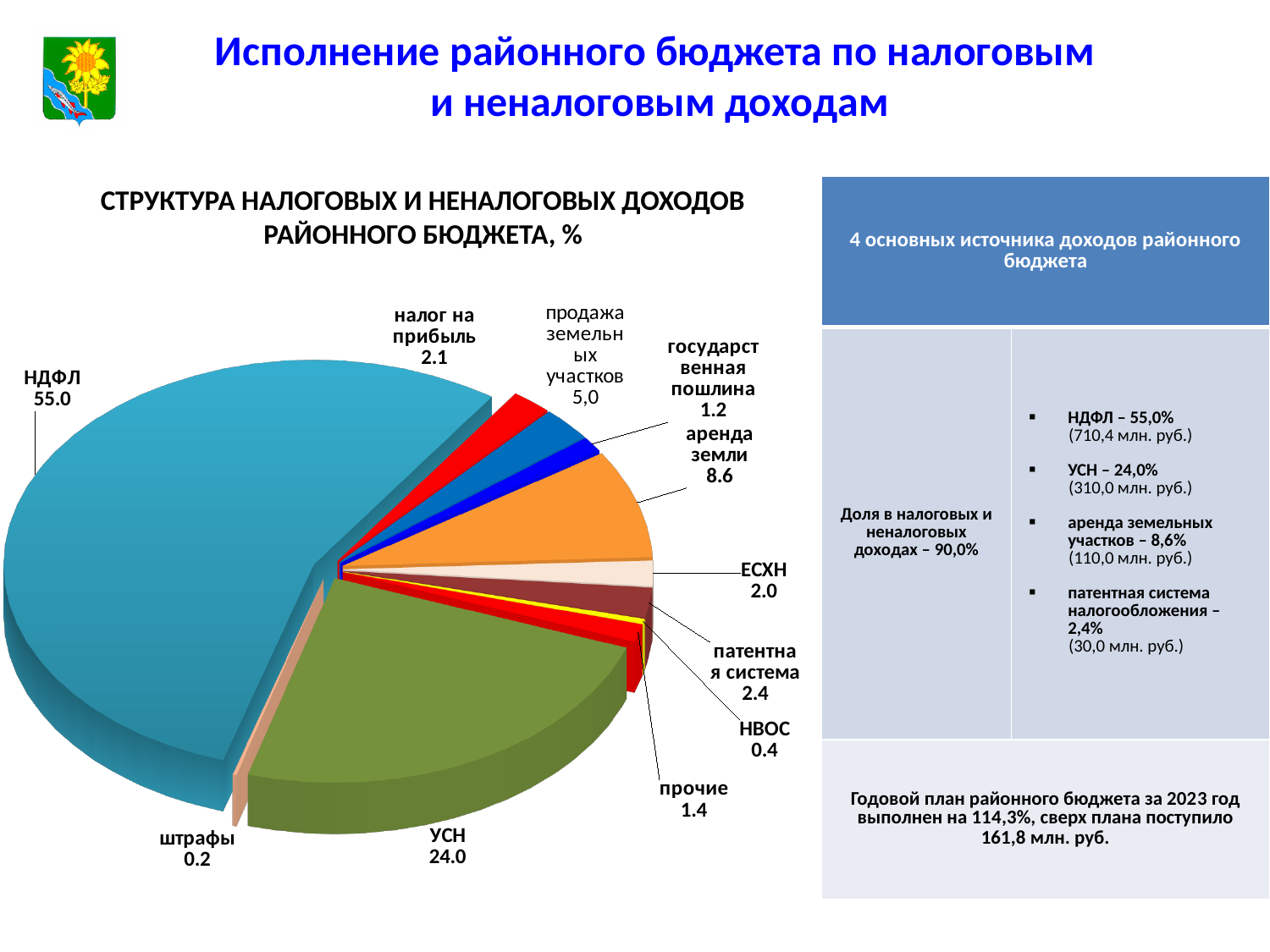
What is the value for штрафы in the pie chart? 0.2 How many categories are shown in the pie chart? 11 What is the value for НДФЛ in the pie chart? 55.0 Which category has the smallest slice in the pie chart? штрафы What is the value for продажа земельных участков in the pie chart? 5,0 What kind of chart is shown on the slide? pie chart What is the title of the pie chart? СТРУКТУРА НАЛОГОВЫХ И НЕНАЛОГОВЫХ ДОХОДОВ РАЙОННОГО БЮДЖЕТА, % What is the difference between the values for НДФЛ and УСН in the pie chart? 31.0 Which is larger in the pie chart, патентная система or ЕСХН? патентная система What is the value for аренда земли in the pie chart? 8.6 What is the value for УСН in the pie chart? 24.0 Which category has the largest slice in the pie chart? НДФЛ